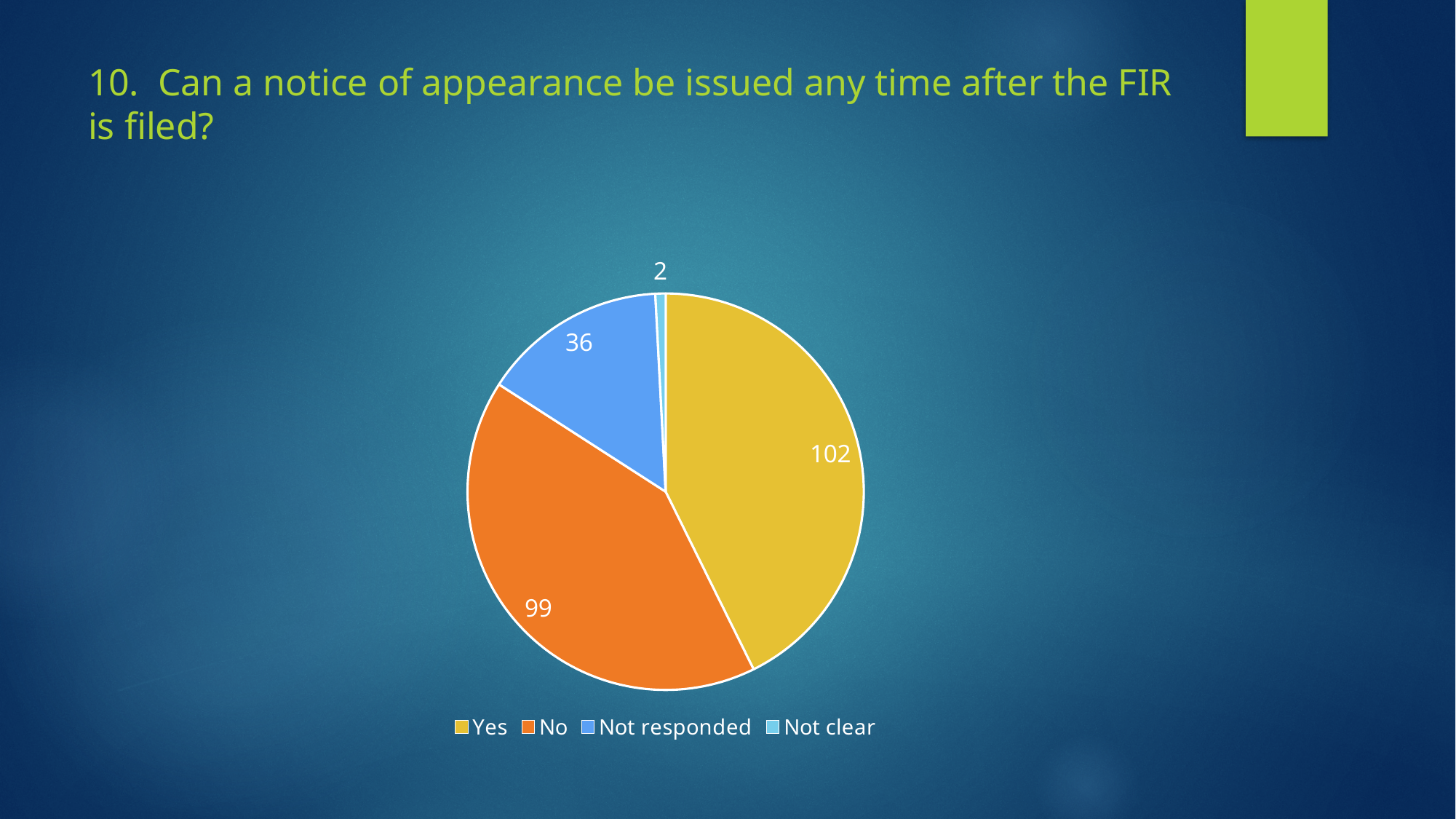
Which is larger, the value for "Yes" or the value for "No"? Yes What is the total of all the slices in the pie chart? 239 What is the difference between the "Yes" and "No" values? 3 Which category has the largest slice of the pie? Yes How many categories does the legend list? 4 What is the value for the "Not responded" slice? 36 What is the difference between the "No" and "Not responded" values? 63 What kind of chart is shown on the slide? Pie chart What is the value for the "Not clear" slice? 2 How many respondents answered "Yes"? 102 How many respondents answered "No"? 99 Which category has the smallest slice of the pie? Not clear